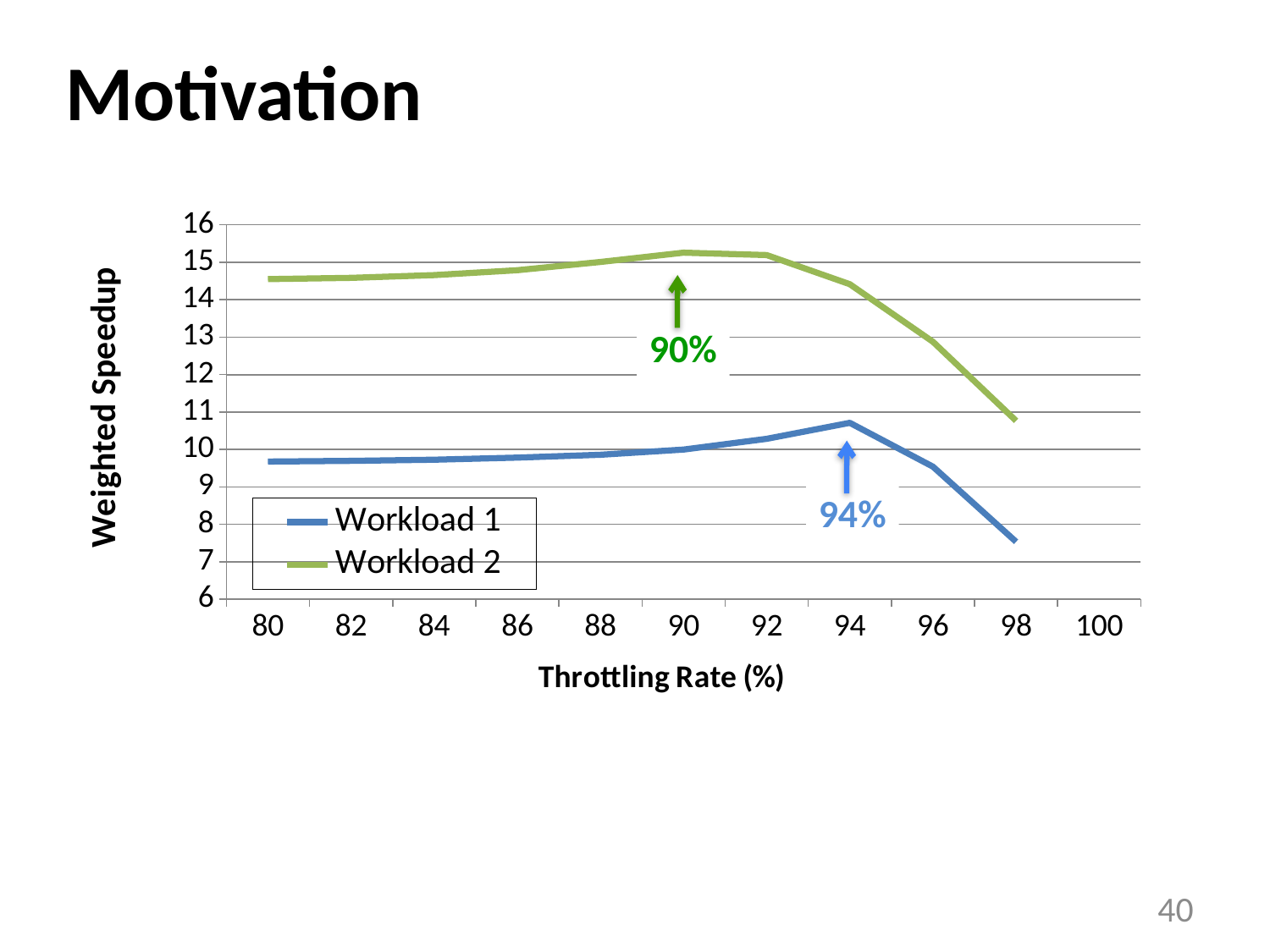
Is the weighted speedup for Workload 1 at a throttling rate of 80 greater or less than 10? less What are the two series named in the legend? Workload 1 and Workload 2 What kind of chart is shown on the slide? line chart Is the weighted speedup for Workload 1 at a throttling rate of 98 greater or less than 8? less What is the title of the x axis? Throttling Rate (%) At which throttling rate does Workload 2 reach its highest weighted speedup, according to the annotation? 90% Is the weighted speedup for Workload 2 at a throttling rate of 80 greater or less than 14? greater At which throttling rate does Workload 1 reach its highest weighted speedup, according to the annotation? 94% Does the weighted speedup for Workload 1 rise or fall as the throttling rate increases from 94 to 98? fall How many series does the legend list? 2 At a throttling rate of 90, which workload has the higher weighted speedup? Workload 2